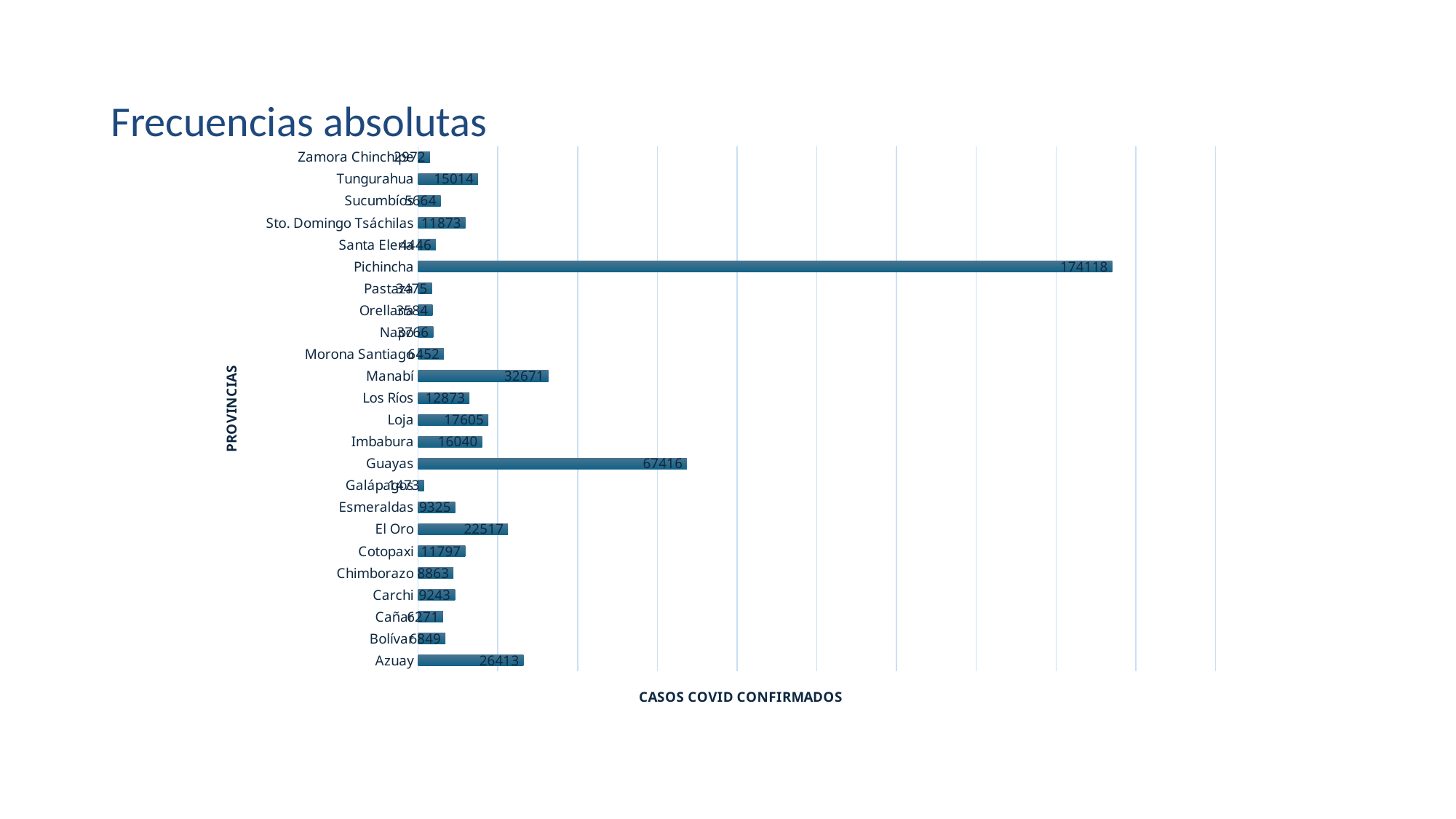
What is the value for Pichincha? 174118 What is the title of the chart on the slide? Frecuencias absolutas What is the label of the horizontal axis? CASOS COVID CONFIRMADOS What is the difference between the values for Pichincha and Guayas? 106702 What is the value for Azuay? 26413 How many provinces are plotted in the chart? 24 Which province has the highest number of confirmed COVID cases? Pichincha Which has a larger value, El Oro or Azuay? Azuay Which province has the lowest number of confirmed COVID cases? Galápagos What is the value for Manabí? 32671 What type of chart is shown on the slide? bar chart What is the value for Guayas? 67416